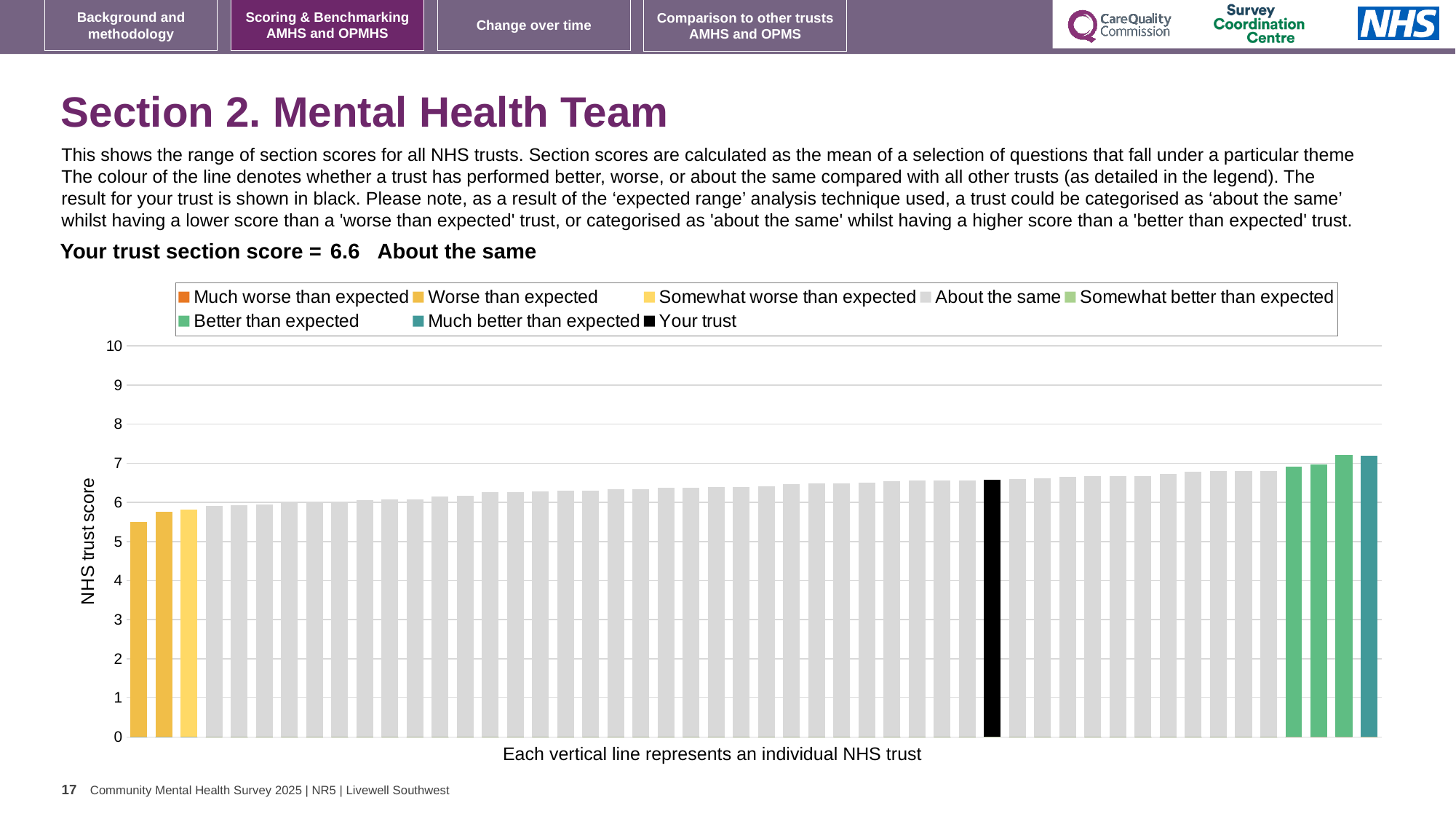
What is the label on the vertical axis of the chart? NHS trust score What kind of chart is shown on the slide? bar chart What is the section score for your trust shown on the slide? 6.6 Which category is your trust placed in according to the slide? About the same How many entries does the chart legend list? 8 Is the value of the black 'Your trust' bar greater or less than 8? less Do the bar values rise or fall from left to right along the x axis? rise Is the value of the black 'Your trust' bar greater or less than 6? greater Is the value of the leftmost (lowest) bar greater or less than 6? less What colour is the bar representing your trust? black